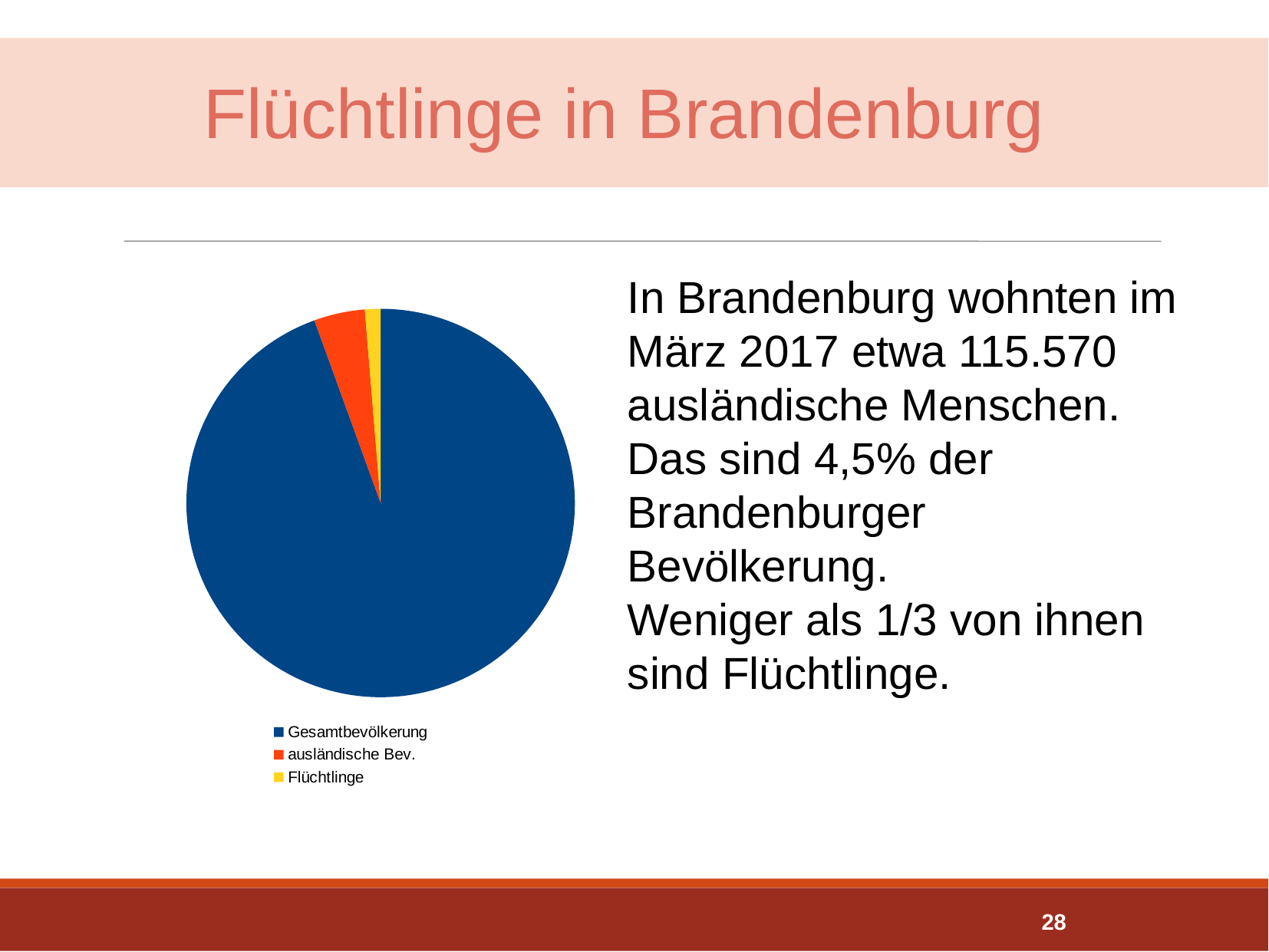
Which category is shown in yellow in the pie chart? Flüchtlinge What kind of chart is shown on the slide? pie chart How many entries does the legend of the pie chart list? 3 What colour is the Gesamtbevölkerung slice in the pie chart? blue Which slice is larger in the pie chart, Gesamtbevölkerung or ausländische Bev.? Gesamtbevölkerung Which category has the largest slice in the pie chart? Gesamtbevölkerung Which slice is larger in the pie chart, ausländische Bev. or Flüchtlinge? ausländische Bev. Which category has the smallest slice in the pie chart? Flüchtlinge How many slices does the pie chart have? 3